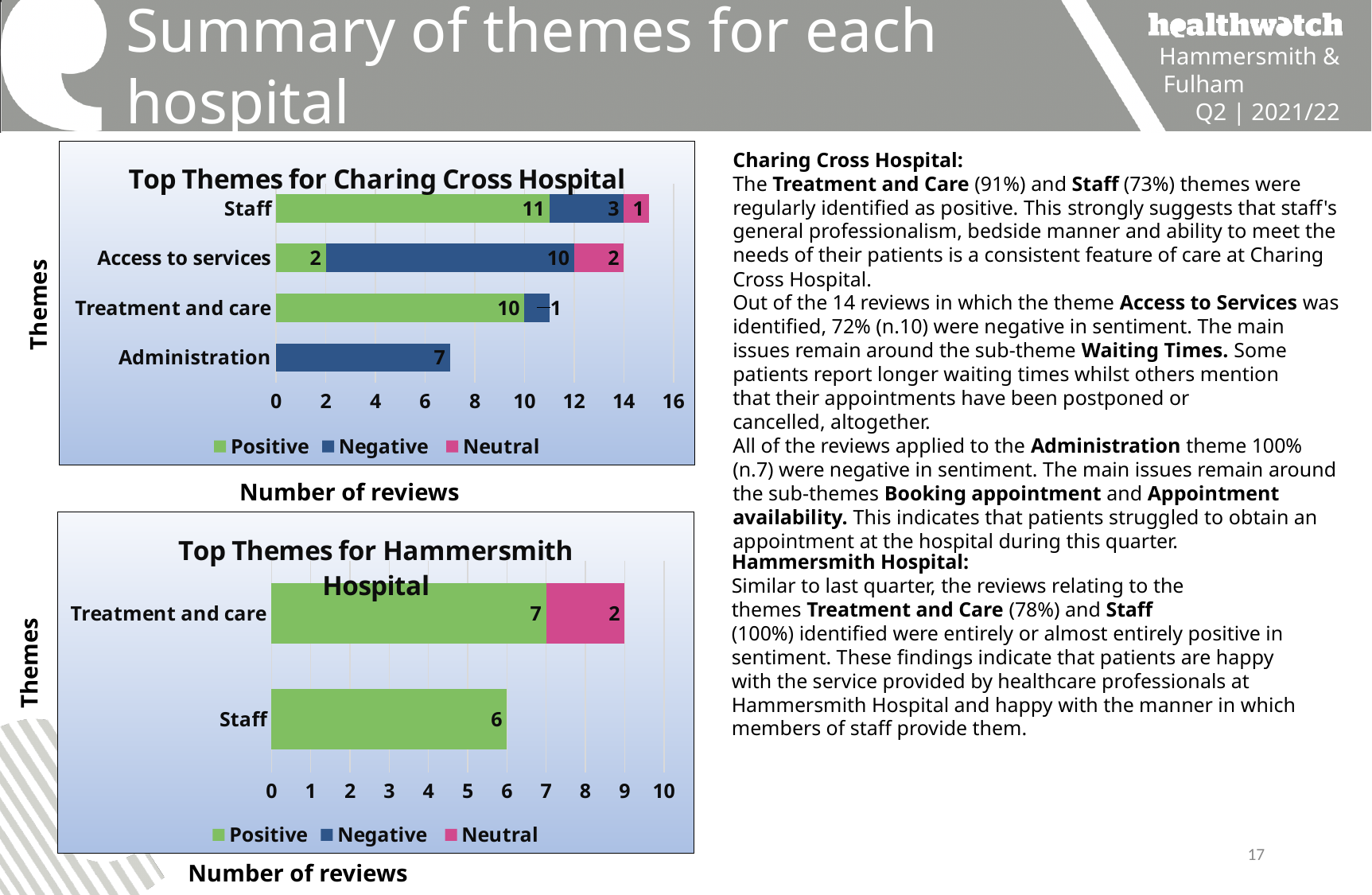
In the Top Themes for Charing Cross Hospital chart, what is the difference between the Positive values for Staff and Treatment and care? 1 In the Top Themes for Charing Cross Hospital chart, what is the Negative value for Administration? 7 In the Top Themes for Charing Cross Hospital chart, what is the Negative value for Access to services? 10 In the Top Themes for Charing Cross Hospital chart, what is the total number of reviews for Staff across all three sentiments? 15 In the Top Themes for Charing Cross Hospital chart, what is the Positive value for Staff? 11 How many series does the legend of the Top Themes for Hammersmith Hospital chart list? 3 In the Top Themes for Charing Cross Hospital chart, what is the total number of reviews for Access to services? 14 In the Top Themes for Hammersmith Hospital chart, which theme has the larger Positive value, Treatment and care or Staff? Treatment and care In the Top Themes for Charing Cross Hospital chart, how many themes are shown? 4 In the Top Themes for Hammersmith Hospital chart, what is the total number of reviews for Treatment and care? 9 In the Top Themes for Hammersmith Hospital chart, what is the Positive value for Treatment and care? 7 In the Top Themes for Charing Cross Hospital chart, which theme has the highest Negative value? Access to services